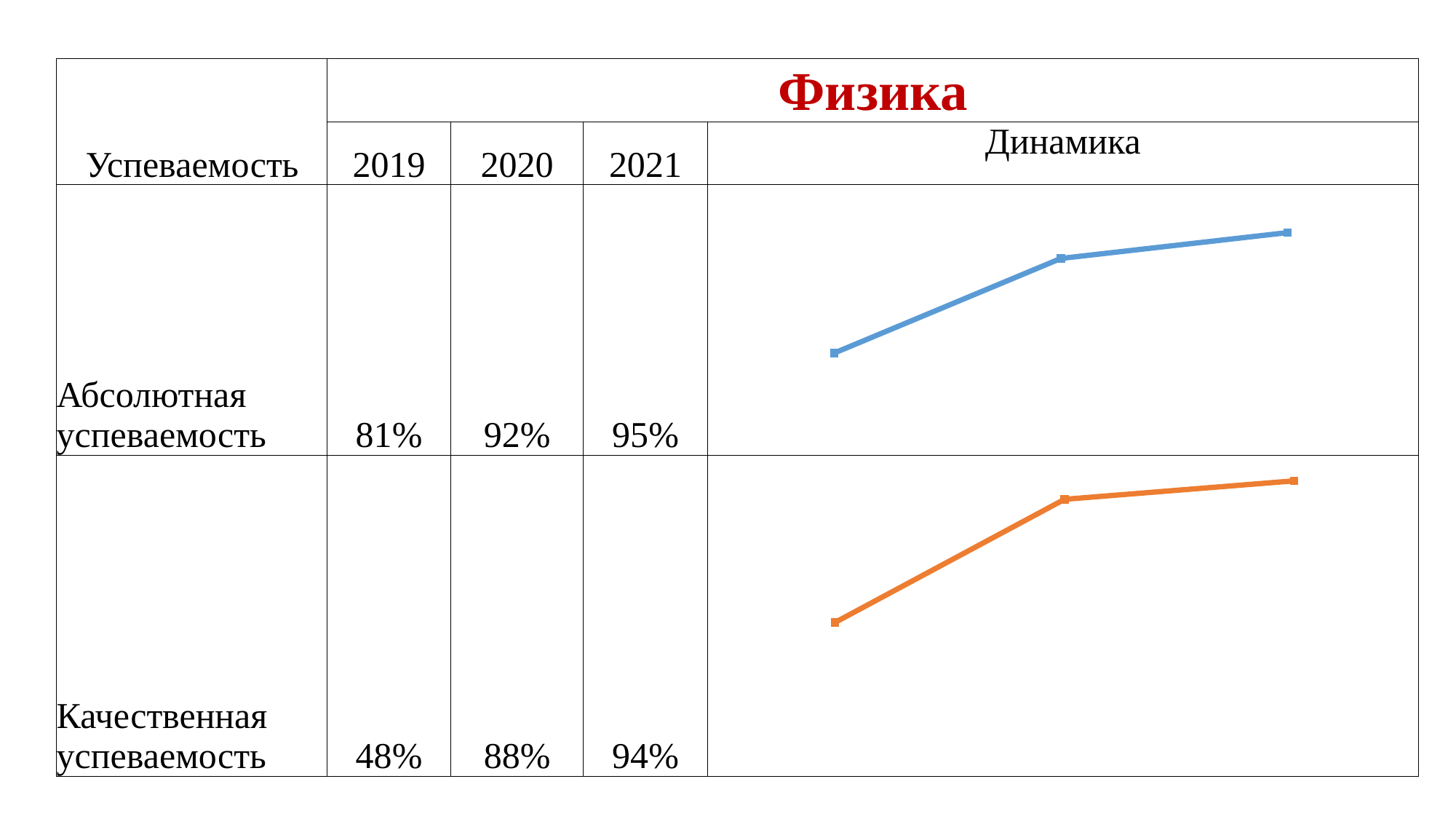
In the lower line chart (Качественная успеваемость), do the values rise or fall from 2019 to 2021? rise In the lower line chart (Качественная успеваемость), what is the value for 2020? 88% In the upper line chart (Абсолютная успеваемость), which year has the highest value? 2021 What kind of chart is shown in the upper row (Абсолютная успеваемость) of the Динамика column? line chart In the lower line chart (Качественная успеваемость), which year has the lowest value? 2019 How many data points does the lower line chart (Качественная успеваемость) have? 3 In the lower line chart (Качественная успеваемость), what is the difference between the 2020 and 2019 values? 40% In the upper line chart (Абсолютная успеваемость), what is the value for 2019? 81% What colour is the line in the lower chart (Качественная успеваемость)? orange In the upper line chart (Абсолютная успеваемость), do the values rise or fall from 2019 to 2021? rise How many data points does the upper line chart (Абсолютная успеваемость) have? 3 What kind of chart is shown in the lower row (Качественная успеваемость) of the Динамика column? line chart